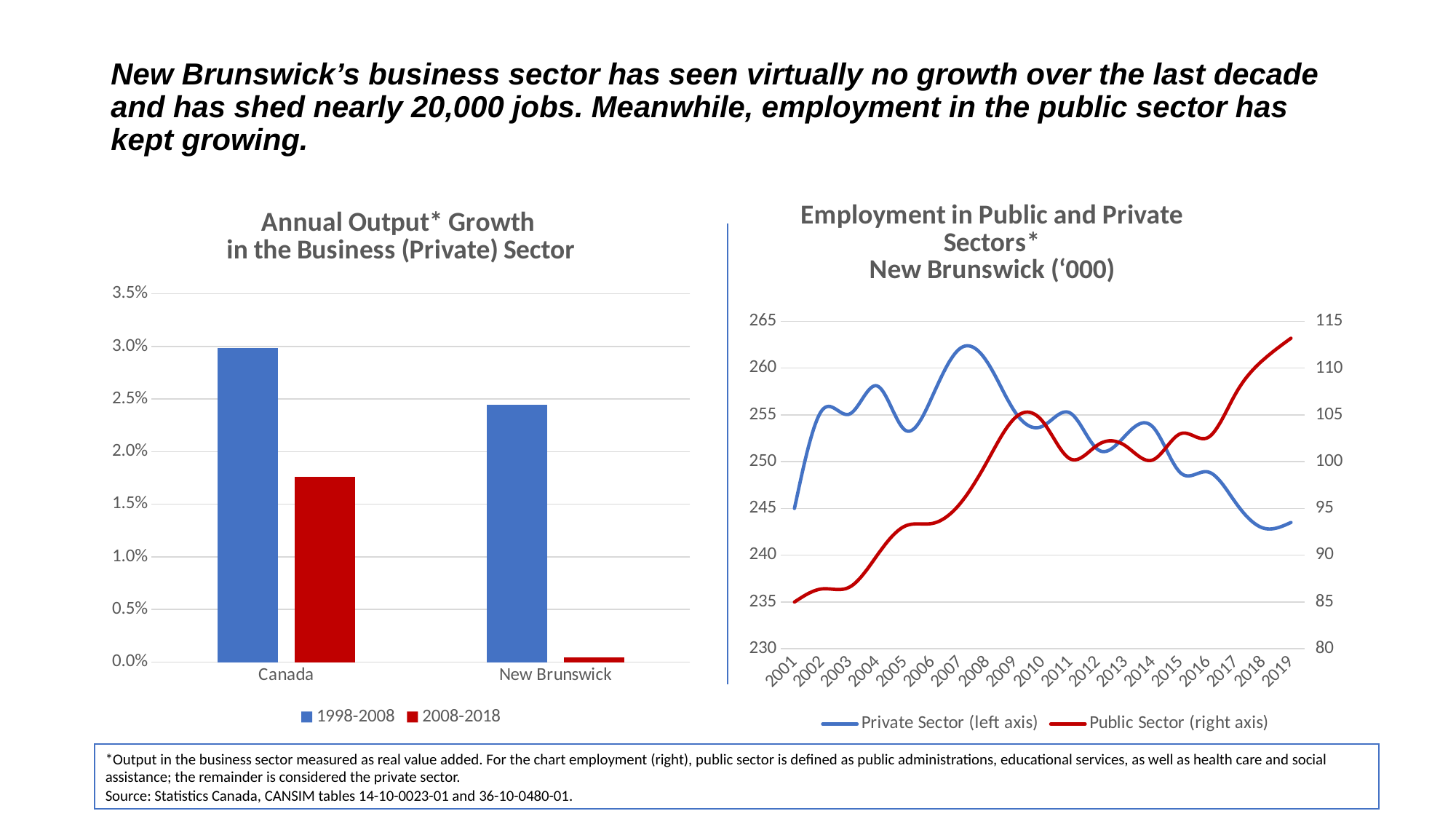
In the right chart, 'Employment in Public and Private Sectors* New Brunswick ('000)', how many series does the legend list? 2 What kind of chart is the 'Annual Output* Growth in the Business (Private) Sector' chart on the left? Bar chart In the left chart, 'Annual Output* Growth in the Business (Private) Sector', is the 1998-2008 value for Canada greater or less than 2.5%? greater In the left chart, 'Annual Output* Growth in the Business (Private) Sector', how many series does the legend list? 2 In the right chart, 'Employment in Public and Private Sectors* New Brunswick ('000)', does the Private Sector line rise or fall from 2008 to 2019? Fall In the right chart, 'Employment in Public and Private Sectors* New Brunswick ('000)', is the Public Sector value in 2019 greater or less than 110 on the right axis? greater In the right chart, 'Employment in Public and Private Sectors* New Brunswick ('000)', which series is plotted in red? Public Sector (right axis) In the left chart, 'Annual Output* Growth in the Business (Private) Sector', is the 2008-2018 value for New Brunswick greater or less than 0.5%? less In the left chart, 'Annual Output* Growth in the Business (Private) Sector', how many categories are shown on the x axis? 2 What kind of chart is the 'Employment in Public and Private Sectors* New Brunswick ('000)' chart on the right? Line chart In the left chart, 'Annual Output* Growth in the Business (Private) Sector', which bar is the highest? Canada, 1998-2008 In the left chart, 'Annual Output* Growth in the Business (Private) Sector', which has the larger 2008-2018 value, Canada or New Brunswick? Canada